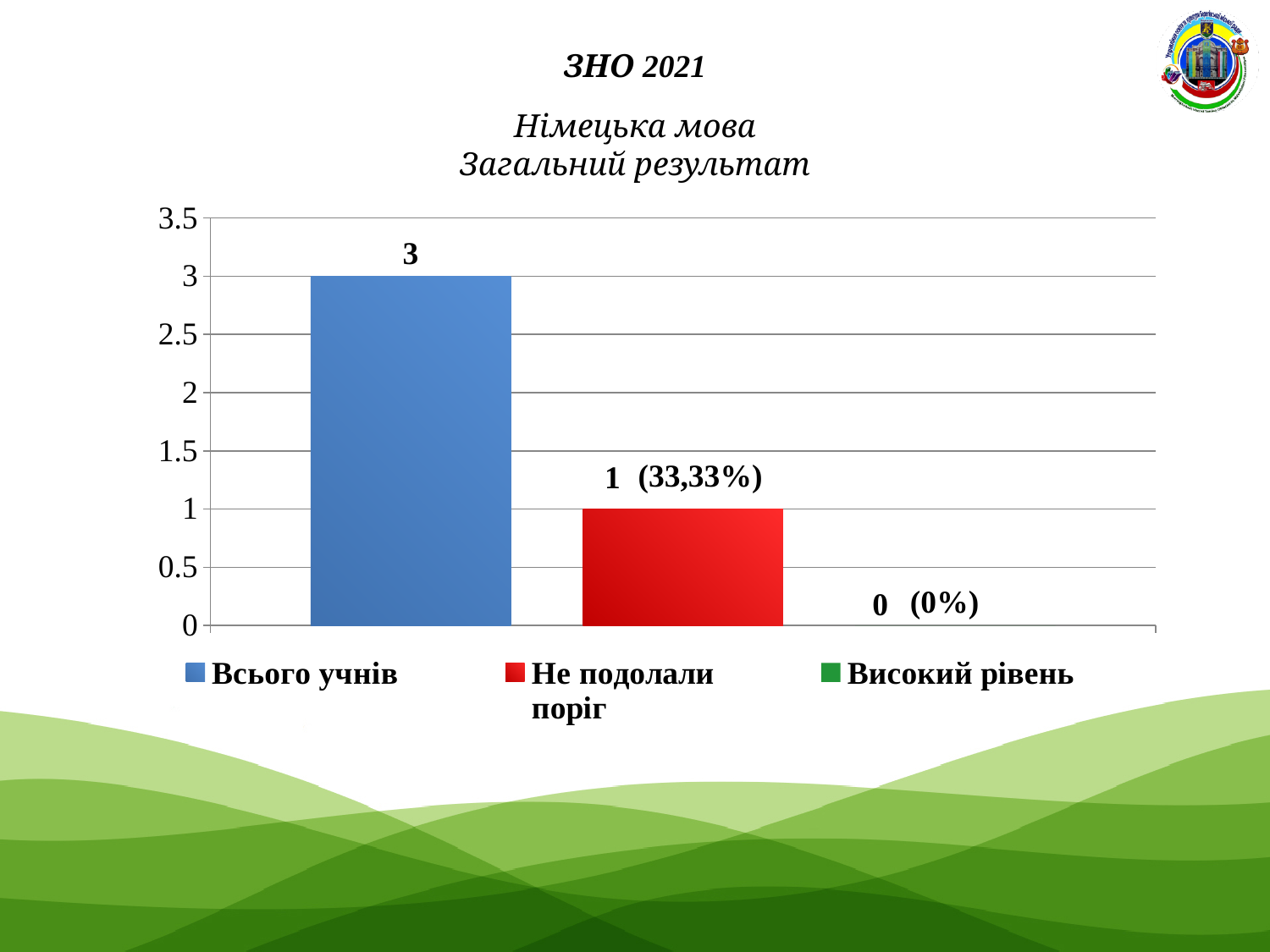
What is the value for Всього учнів? 3 Which series has the lowest value? Високий рівень What is the data label shown for Не подолали поріг? 1 (33,33%) Which series has the highest value? Всього учнів What is the data label shown for Високий рівень? 0 (0%) What kind of chart is shown on the slide? bar chart How many series does the legend list? 3 What is the maximum value shown on the vertical axis? 3.5 Which is larger, the value for Всього учнів or the value for Не подолали поріг? Всього учнів What colour is the bar for Не подолали поріг? red What is the difference between the values for Всього учнів and Не подолали поріг? 2 Is the value for Всього учнів greater or less than 2? greater